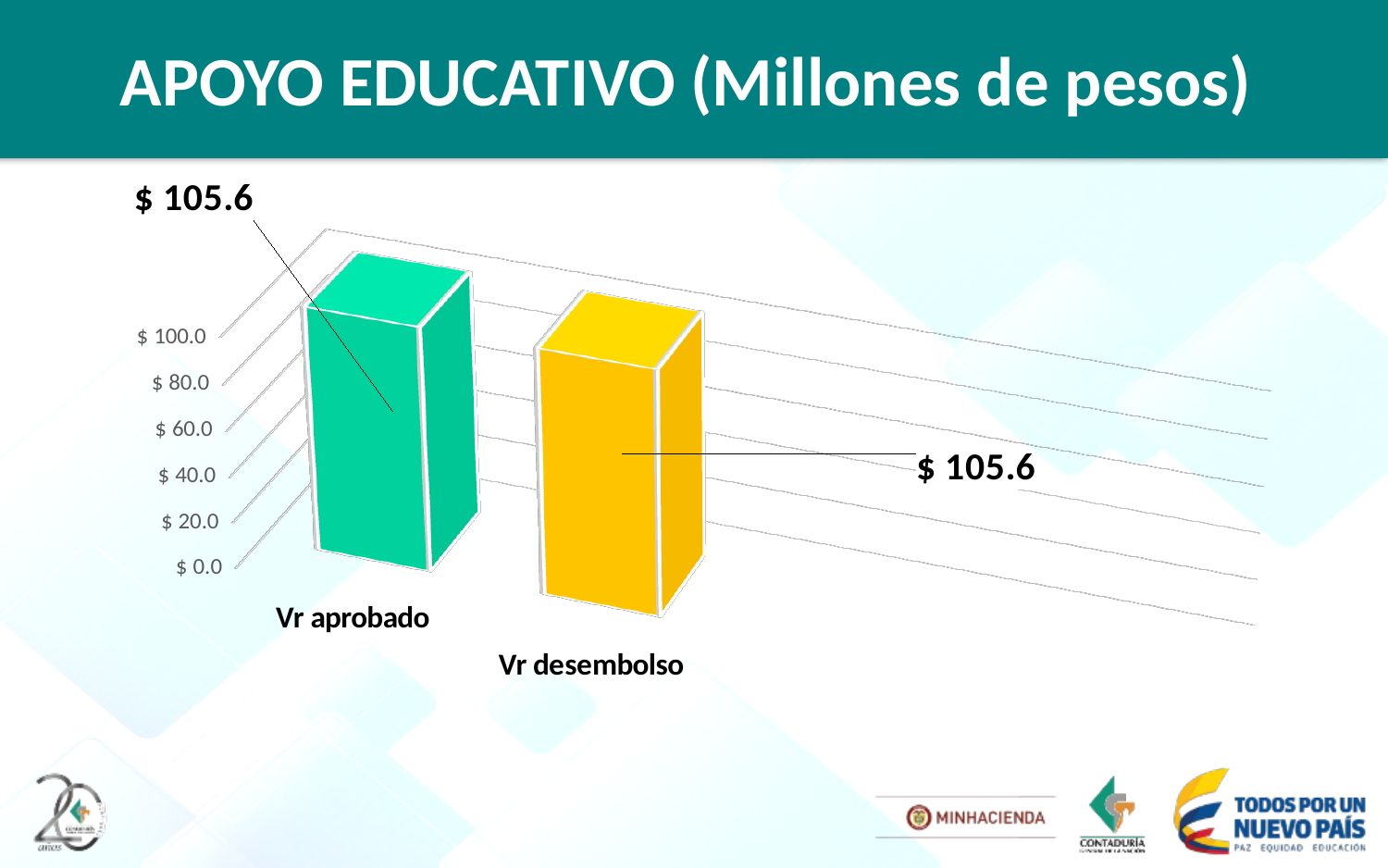
What is the title of the slide's chart? APOYO EDUCATIVO (Millones de pesos) What colour is the bar for Vr desembolso? yellow Do the values rise, fall or stay the same from Vr aprobado to Vr desembolso? stay the same How many categories are plotted in the chart? 2 Is the value for Vr desembolso greater or less than $ 80.0? greater Is the value for Vr aprobado greater or less than $ 100.0? greater What is the value for Vr desembolso? $ 105.6 What kind of chart is shown on the slide? bar chart What is the value for Vr aprobado? $ 105.6 What is the difference between the value for Vr aprobado and the value for Vr desembolso? $ 0.0